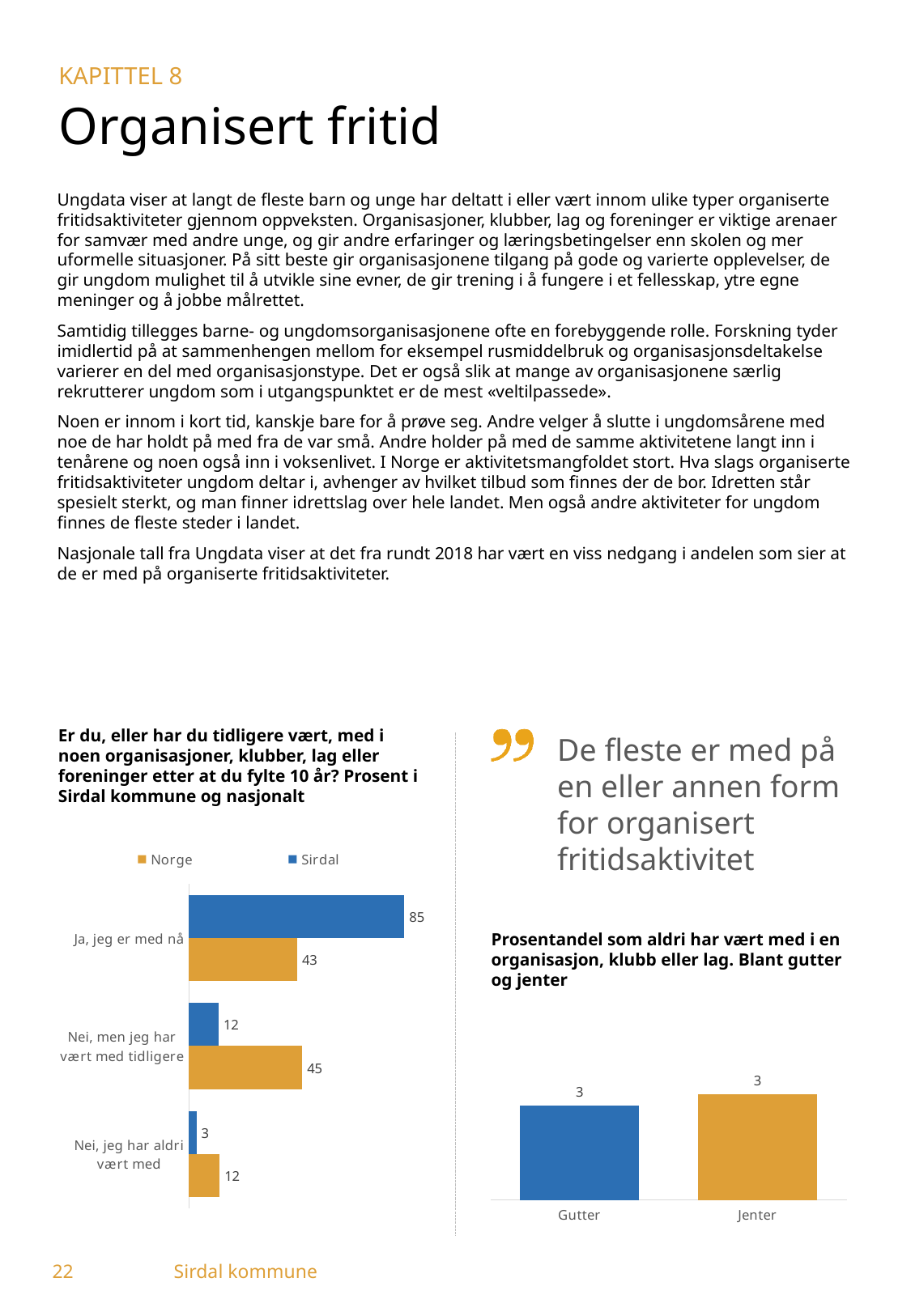
In the left chart (Er du, eller har du tidligere vært, med i noen organisasjoner...), what is the value for Sirdal for 'Ja, jeg er med nå'? 85 In the left chart, what is the value for Norge for 'Nei, men jeg har vært med tidligere'? 45 How many series does the legend of the left chart list? 2 In the left chart, which category has the highest value for Sirdal? Ja, jeg er med nå How many categories are shown in the left chart? 3 In the right chart (Prosentandel som aldri har vært med i en organisasjon, klubb eller lag), what is the value for Jenter? 3 In the left chart, what is the value for Sirdal for 'Nei, jeg har aldri vært med'? 3 What kind of chart is the left chart? Bar chart In the left chart, which category has the lowest value for Norge? Nei, jeg har aldri vært med In the left chart, what is the difference between the Sirdal and Norge values for 'Ja, jeg er med nå'? 42 In the left chart, for 'Nei, men jeg har vært med tidligere', which is larger: Norge or Sirdal? Norge In the right chart, how many categories are shown? 2